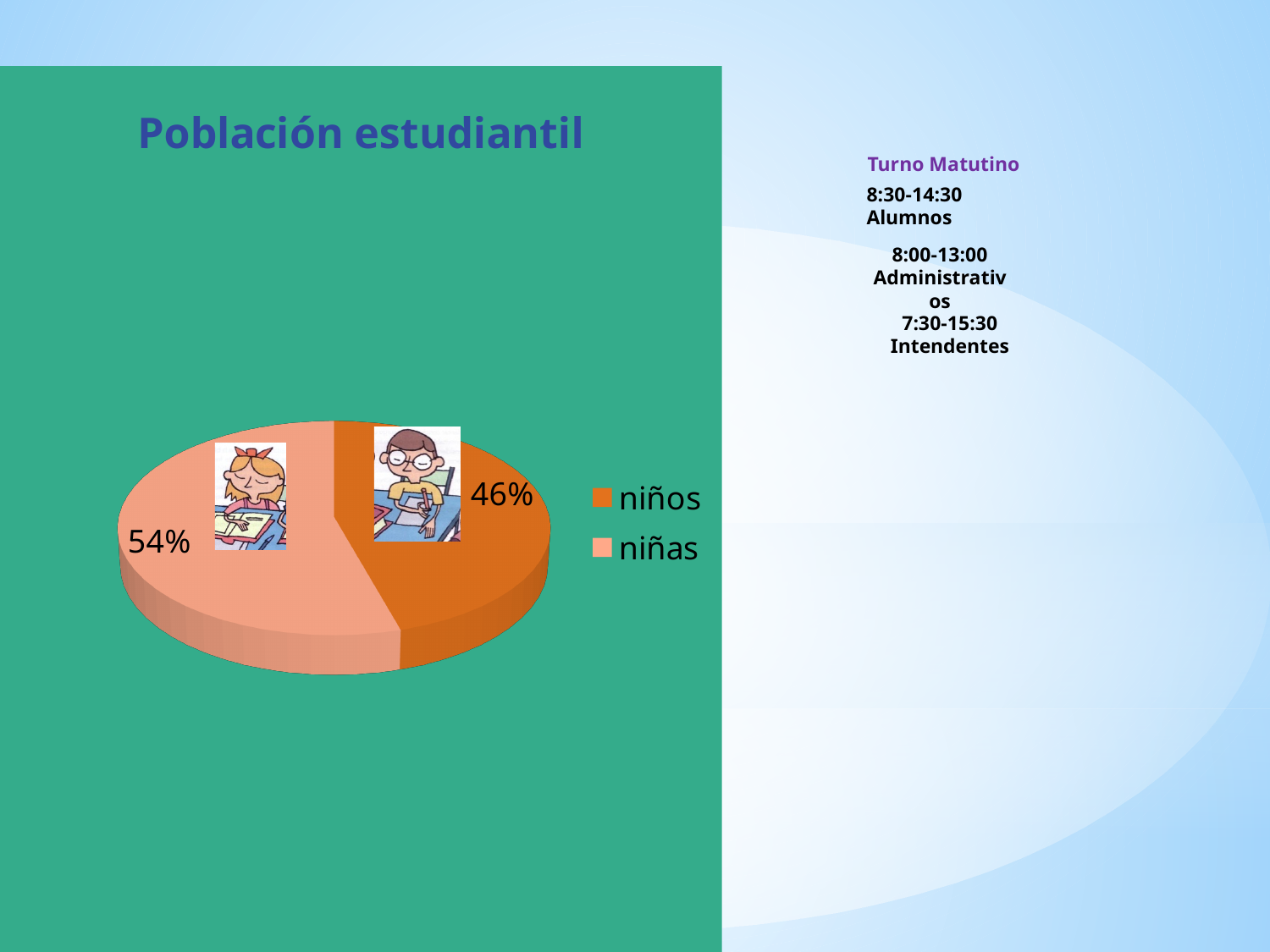
Which legend entry is shown in the darker orange colour? niños What is the title of the slide containing the pie chart? Población estudiantil What is the difference in percentage points between niñas and niños? 8 Is the share for niñas greater or less than 50%? greater What kind of chart is shown on the slide? pie chart How many slices does the pie chart have? 2 What percentage of the pie chart is niños? 46% How many entries does the legend list? 2 Which slice of the pie chart is the largest? niñas Which slice of the pie chart is the smallest? niños What percentage of the pie chart is niñas? 54% Which is larger, the share for niños or the share for niñas? niñas